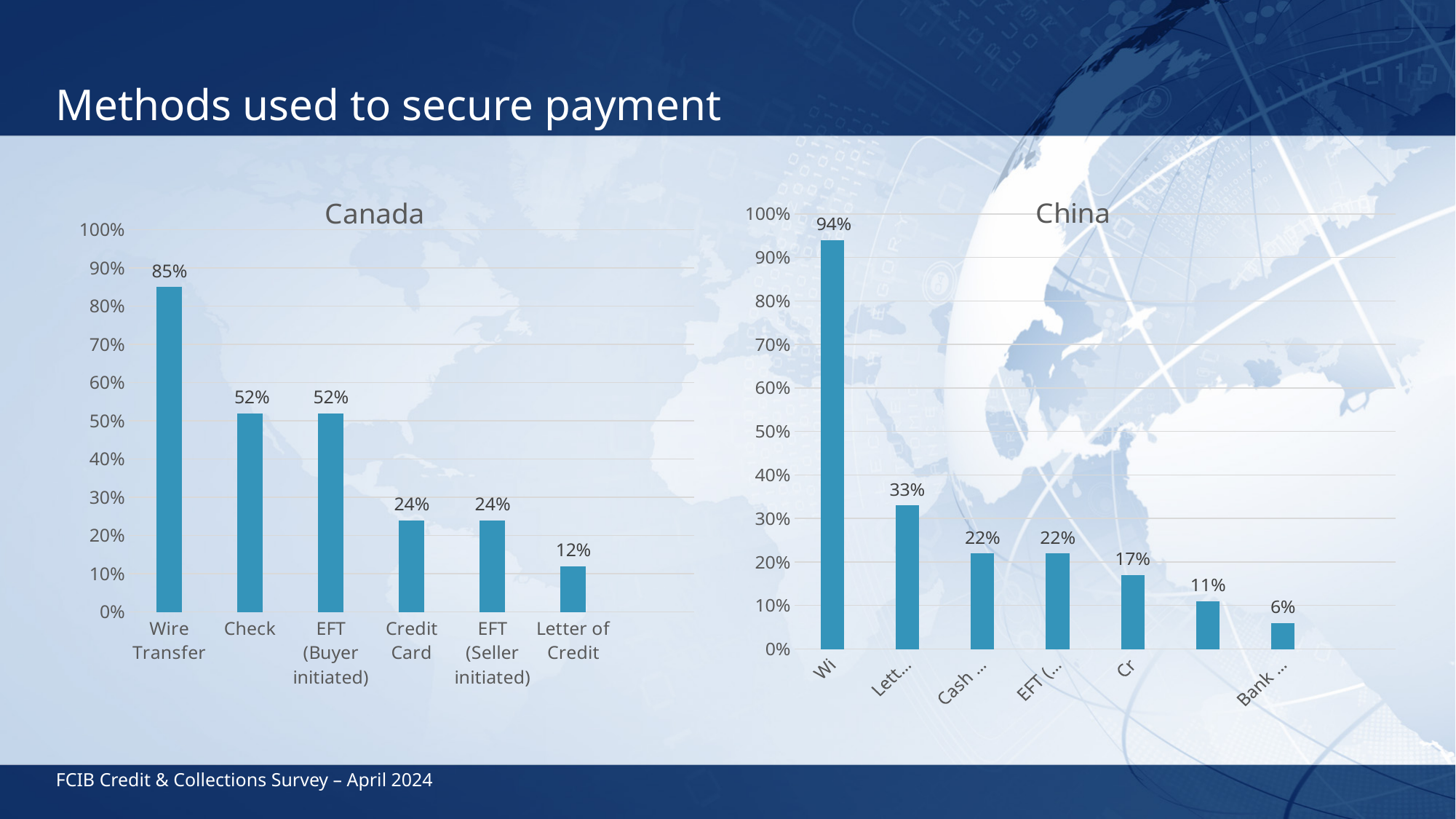
In the Canada chart, what is the value for Wire Transfer? 85% How many bars are shown in the China chart? 7 What kind of chart is the China chart? Bar chart In the China chart, what is the lowest value shown? 6% In the Canada chart, which is larger, Check or Credit Card? Check In the China chart, what is the highest value shown? 94% In the Canada chart, which category has the highest value? Wire Transfer In the Canada chart, which category has the lowest value? Letter of Credit In the Canada chart, what is the difference between Wire Transfer and Check? 33% How many categories are shown in the Canada chart? 6 In the Canada chart, what is the value for Credit Card? 24% In the Canada chart, what is the value for Letter of Credit? 12%